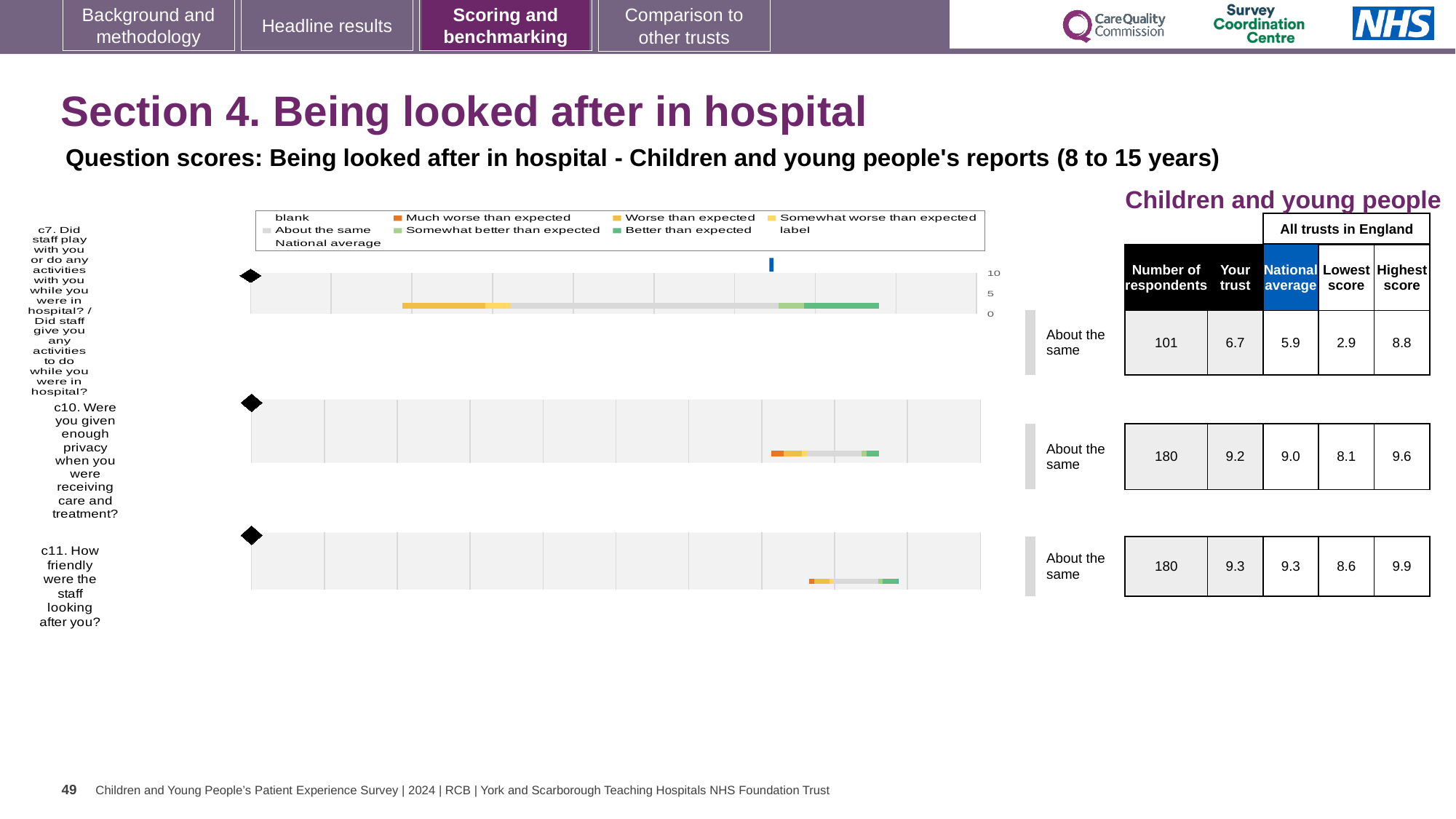
How many respondents answered question c7? 101 What is the national average score for question c10 (Were you given enough privacy when you were receiving care and treatment?)? 9.0 What is the 'Your trust' score for question c7 (Did staff play with you or do any activities with you while you were in hospital?)? 6.7 What colour does the legend use for 'Better than expected'? Green For question c7, which is larger: the 'Your trust' score or the national average? Your trust How many questions (c7, c10, c11) have a benchmark bar chart on this slide? 3 Which question has the highest 'Your trust' score? c11 What kind of chart is used to show the question scores on this slide? Bar chart What benchmark category is shown for question c11? About the same What is the difference between the highest score and the lowest score for question c10? 1.5 Which question has the lowest 'Lowest score' across all trusts in England? c7 What is the highest score across all trusts in England for question c11 (How friendly were the staff looking after you?)? 9.9